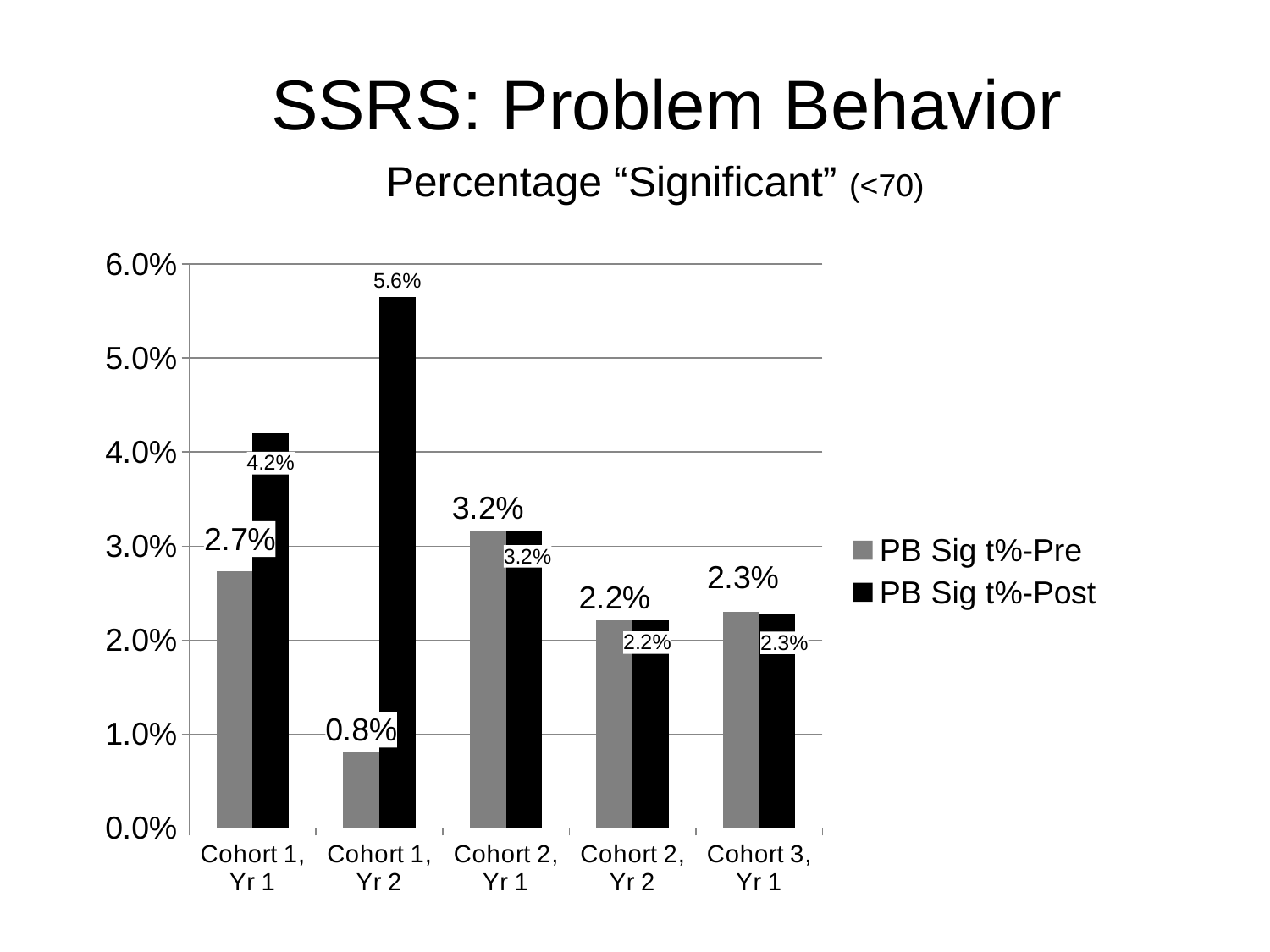
Which series is shown in black in the legend? PB Sig t%-Post What is the PB Sig t%-Pre value for Cohort 1, Yr 1? 2.7% What is the difference between the PB Sig t%-Post and PB Sig t%-Pre values for Cohort 1, Yr 1? 1.5 percentage points For Cohort 1, Yr 2, which is larger: the PB Sig t%-Pre value or the PB Sig t%-Post value? PB Sig t%-Post What kind of chart is shown on the slide? Bar chart What is the PB Sig t%-Pre value for Cohort 2, Yr 1? 3.2% Which category has the highest PB Sig t%-Post value? Cohort 1, Yr 2 What is the PB Sig t%-Post value for Cohort 1, Yr 2? 5.6% How many categories are shown on the x axis? 5 What is the PB Sig t%-Post value for Cohort 3, Yr 1? 2.3% Which category has the lowest PB Sig t%-Pre value? Cohort 1, Yr 2 How many series does the legend list? 2